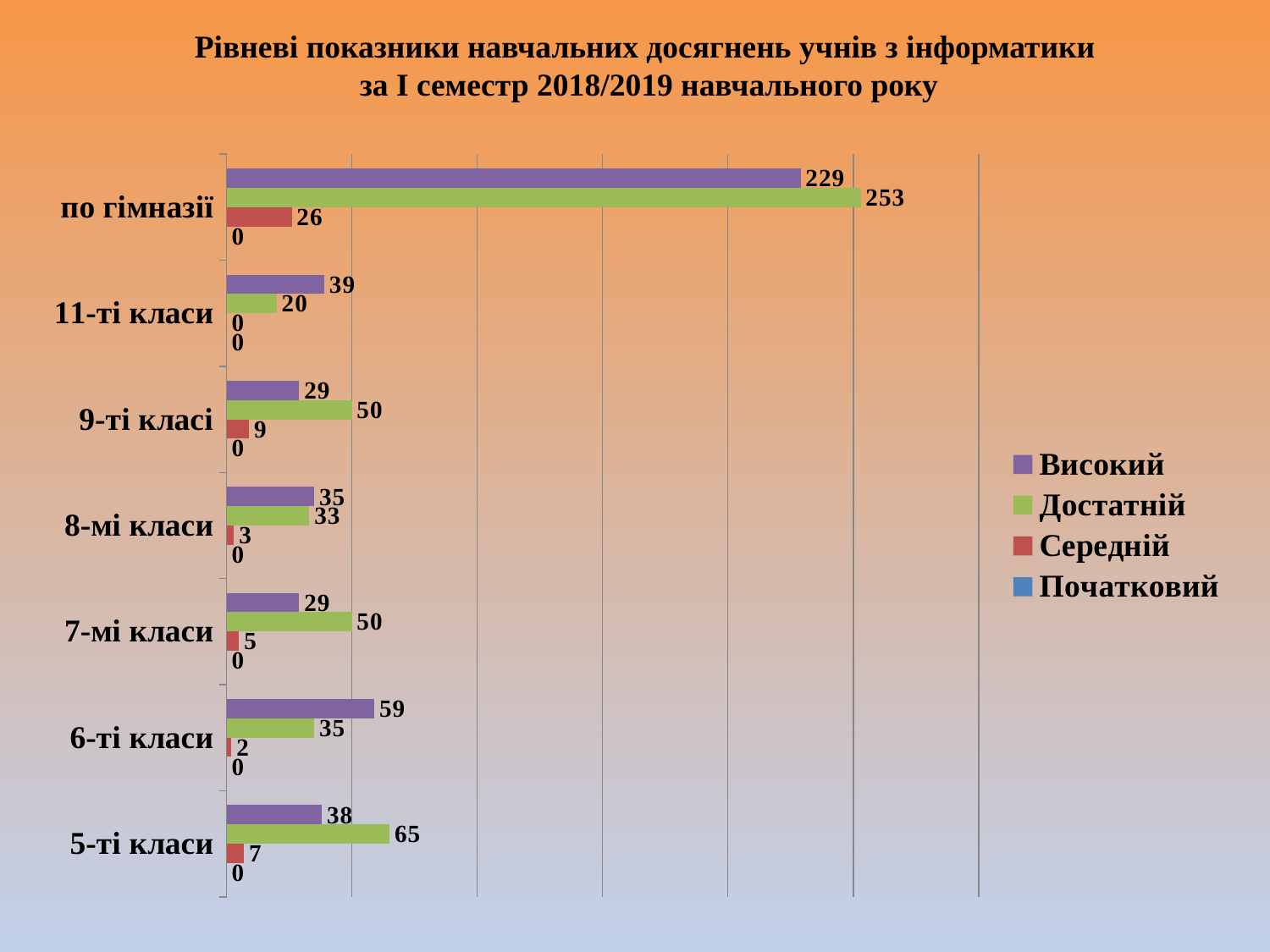
How many categories are shown on the vertical axis? 7 Which is larger for 8-мі класи: Високий or Достатній? Високий What kind of chart is shown on the slide? Bar chart Which class category has the lowest Достатній value? 11-ті класи Which class category has the highest Високий value (excluding по гімназії)? 6-ті класи What is the value of Достатній for 5-ті класи? 65 What is the value of Достатній for по гімназії? 253 How many series does the legend list? 4 What is the difference between the Достатній and Високий values for по гімназії? 24 What is the value of Середній for 9-ті класі? 9 What is the value of Високий for 6-ті класи? 59 What is the value of Початковий for 7-мі класи? 0